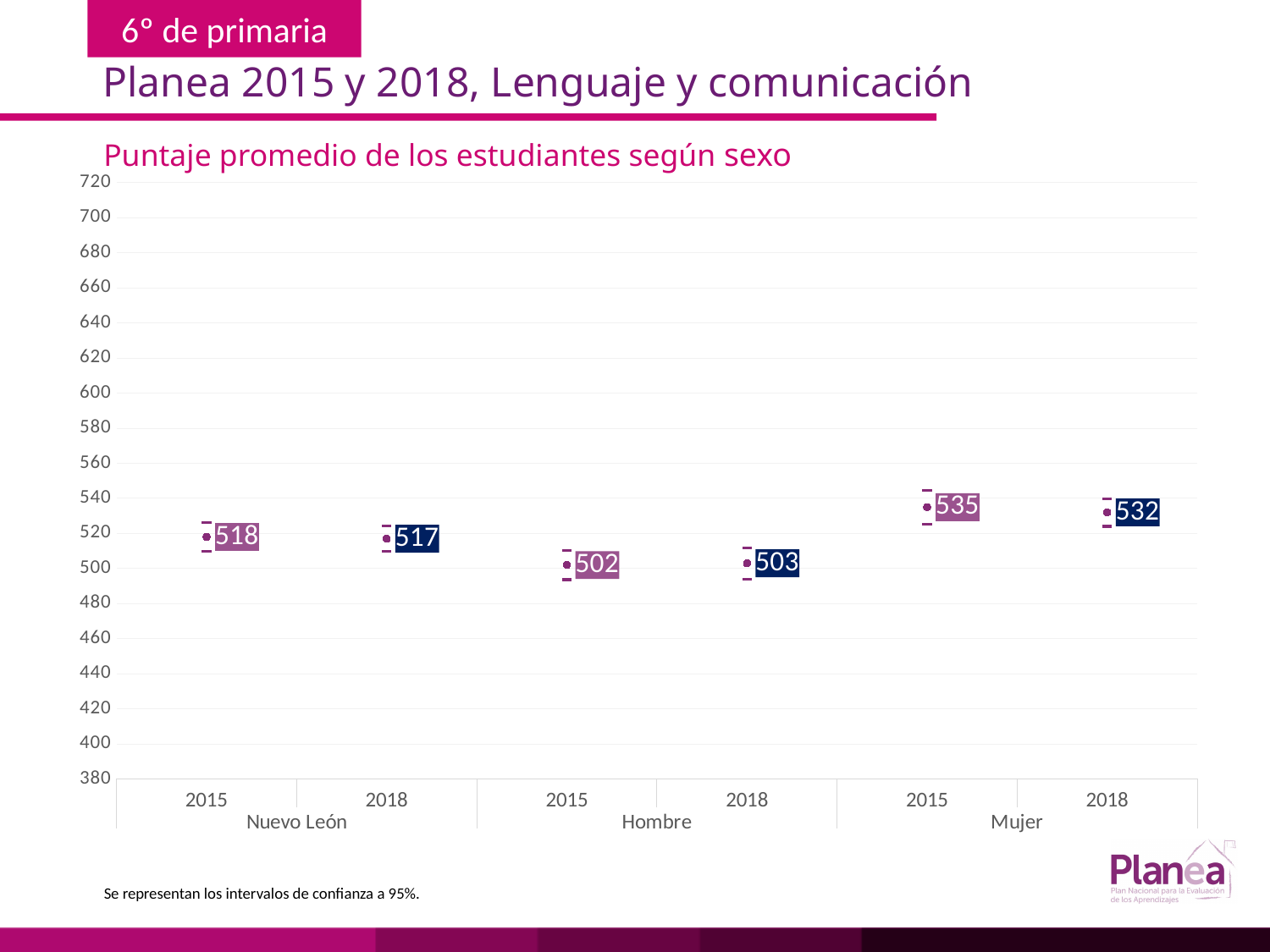
Which group and year has the lowest average score? Hombre 2015 What is the average score for Nuevo León in 2015? 518 Which group and year has the highest average score? Mujer 2015 What is the average score for Hombre in 2018? 503 What is the title of the chart? Puntaje promedio de los estudiantes según sexo What is the difference between the Mujer score and the Hombre score in 2015? 33 How many data points are plotted on the chart? 6 How many groups are shown along the x axis? 3 What is the difference between the Nuevo León scores in 2015 and 2018? 1 What is the average score for Mujer in 2015? 535 Which is larger, the Mujer score in 2015 or the Mujer score in 2018? Mujer 2015 What is the average score for Mujer in 2018? 532